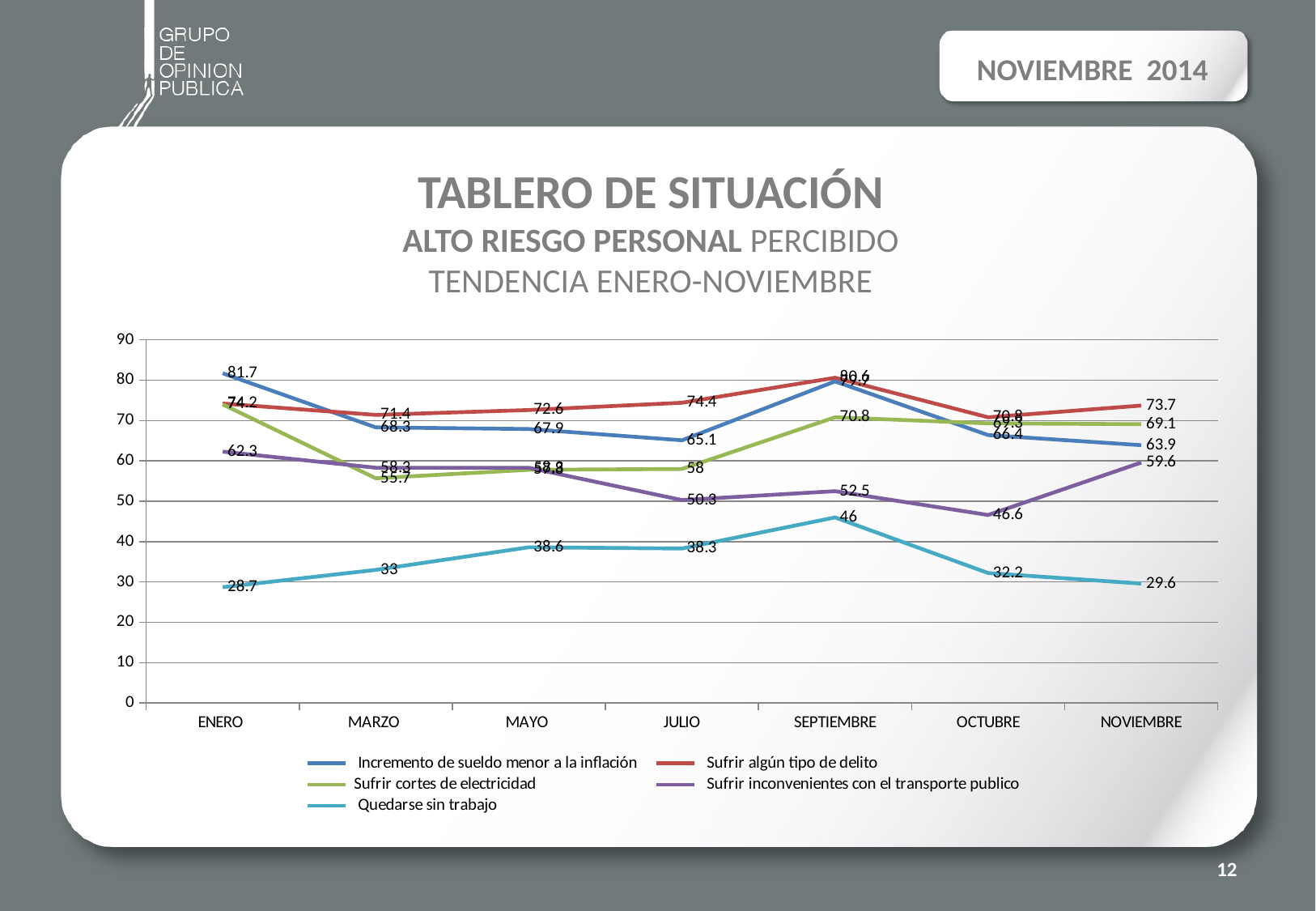
What is the value for 'Sufrir inconvenientes con el transporte publico' in NOVIEMBRE? 59.6 What is the difference between the 'Incremento de sueldo menor a la inflación' values in ENERO and NOVIEMBRE? 17.8 What is the value for 'Quedarse sin trabajo' in ENERO? 28.7 How many months are shown on the x axis? 7 In NOVIEMBRE, which is larger: 'Sufrir algún tipo de delito' or 'Incremento de sueldo menor a la inflación'? Sufrir algún tipo de delito How many series does the legend list? 5 In which month does 'Quedarse sin trabajo' reach its highest value? SEPTIEMBRE Is the value for 'Quedarse sin trabajo' in MAYO greater or less than 40? less What is the value for 'Incremento de sueldo menor a la inflación' in ENERO? 81.7 What kind of chart is shown on the slide? line chart What is the difference between the 'Quedarse sin trabajo' values in SEPTIEMBRE and NOVIEMBRE? 16.4 In which month does 'Sufrir inconvenientes con el transporte publico' reach its lowest value? OCTUBRE